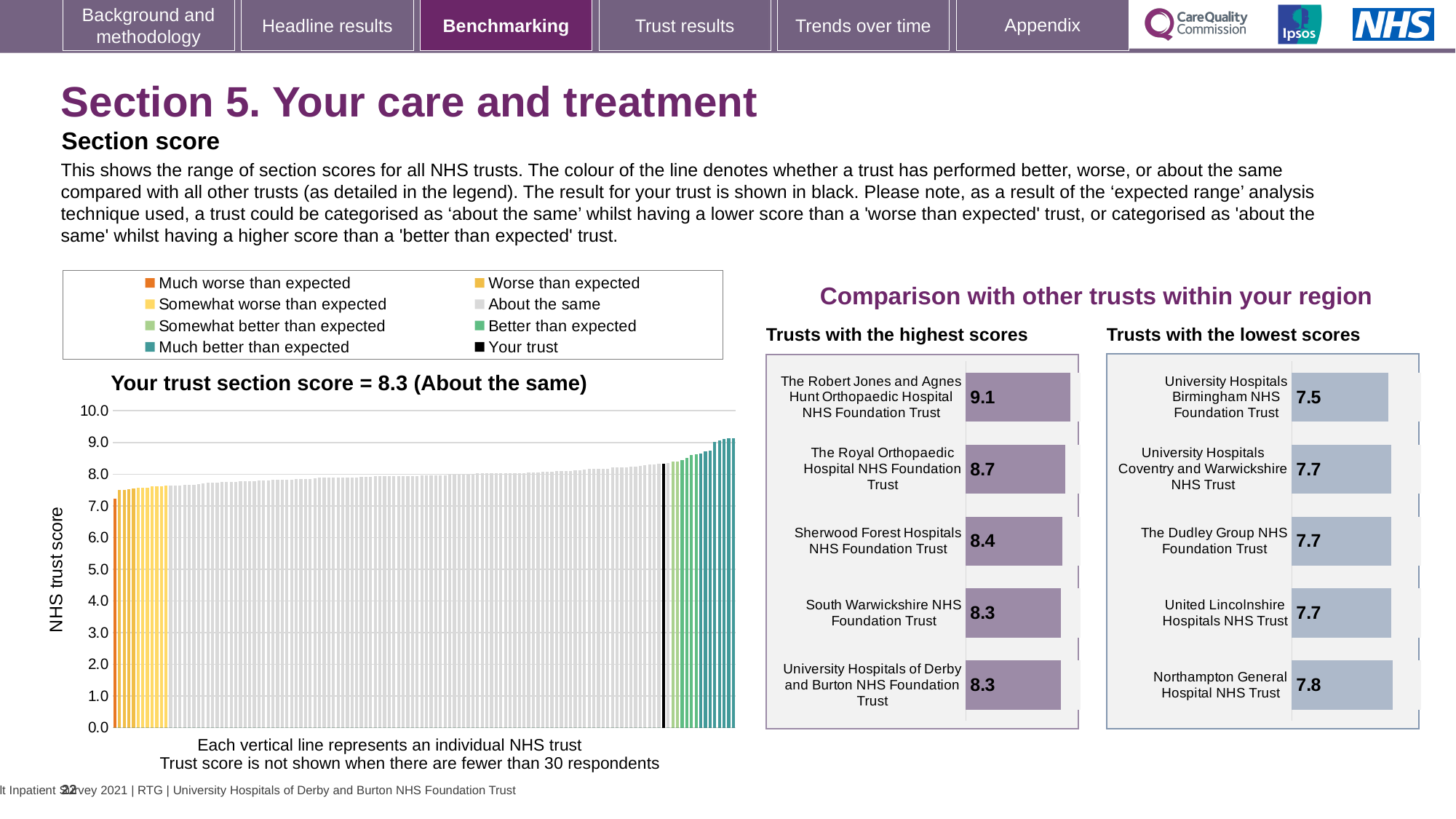
What kind of chart is the 'Your trust section score' chart? bar chart In the 'Trusts with the highest scores' chart, how many trusts are shown? 5 In the 'Trusts with the lowest scores' chart, which has the larger score: Northampton General Hospital NHS Trust or University Hospitals Birmingham NHS Foundation Trust? Northampton General Hospital NHS Trust In the 'Your trust section score' chart, what is the section score for your trust? 8.3 In the 'Trusts with the lowest scores' chart, what is the score for University Hospitals Birmingham NHS Foundation Trust? 7.5 In the 'Your trust section score' chart, what is the label of the vertical axis? NHS trust score How many entries does the legend above the 'Your trust section score' chart list? 8 In the 'Trusts with the highest scores' chart, which trust has the highest score? The Robert Jones and Agnes Hunt Orthopaedic Hospital NHS Foundation Trust In the 'Trusts with the highest scores' chart, what is the score for The Robert Jones and Agnes Hunt Orthopaedic Hospital NHS Foundation Trust? 9.1 In the 'Your trust section score' chart, is the value of the lowest (leftmost) bar greater or less than 8.0? less In the 'Trusts with the lowest scores' chart, which trust has the lowest score? University Hospitals Birmingham NHS Foundation Trust In the 'Trusts with the highest scores' chart, what is the difference between the scores of The Robert Jones and Agnes Hunt Orthopaedic Hospital NHS Foundation Trust and The Royal Orthopaedic Hospital NHS Foundation Trust? 0.4